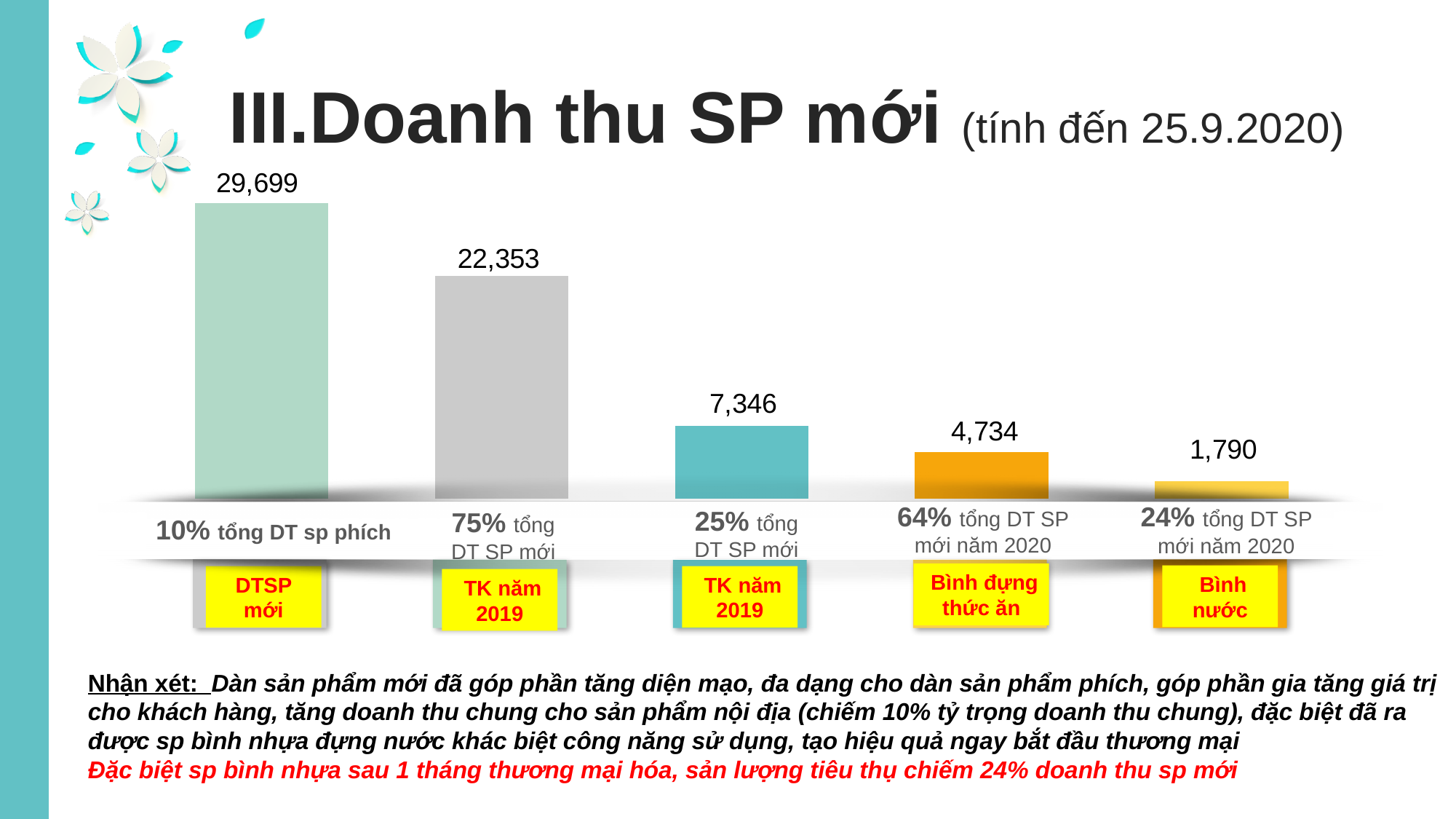
How many bars are shown in the chart? 5 What is the value of the bar labelled "DTSP mới"? 29,699 What is the value of the second bar from the left, the "TK năm 2019" bar annotated "75% tổng DT SP mới"? 22,353 What is the value of the bar labelled "Bình nước"? 1,790 Which bar has the lowest value? Bình nước What kind of chart is shown on the slide? Bar chart Which bar has the highest value? DTSP mới Which is larger, the value for "Bình đựng thức ăn" or the value for "Bình nước"? Bình đựng thức ăn What is the value of the bar labelled "Bình đựng thức ăn"? 4,734 What is the difference between the "DTSP mới" bar and the second bar from the left (22,353)? 7,346 What is the value of the third bar from the left, the "TK năm 2019" bar annotated "25% tổng DT SP mới"? 7,346 What is the difference between the "Bình đựng thức ăn" bar and the "Bình nước" bar? 2,944